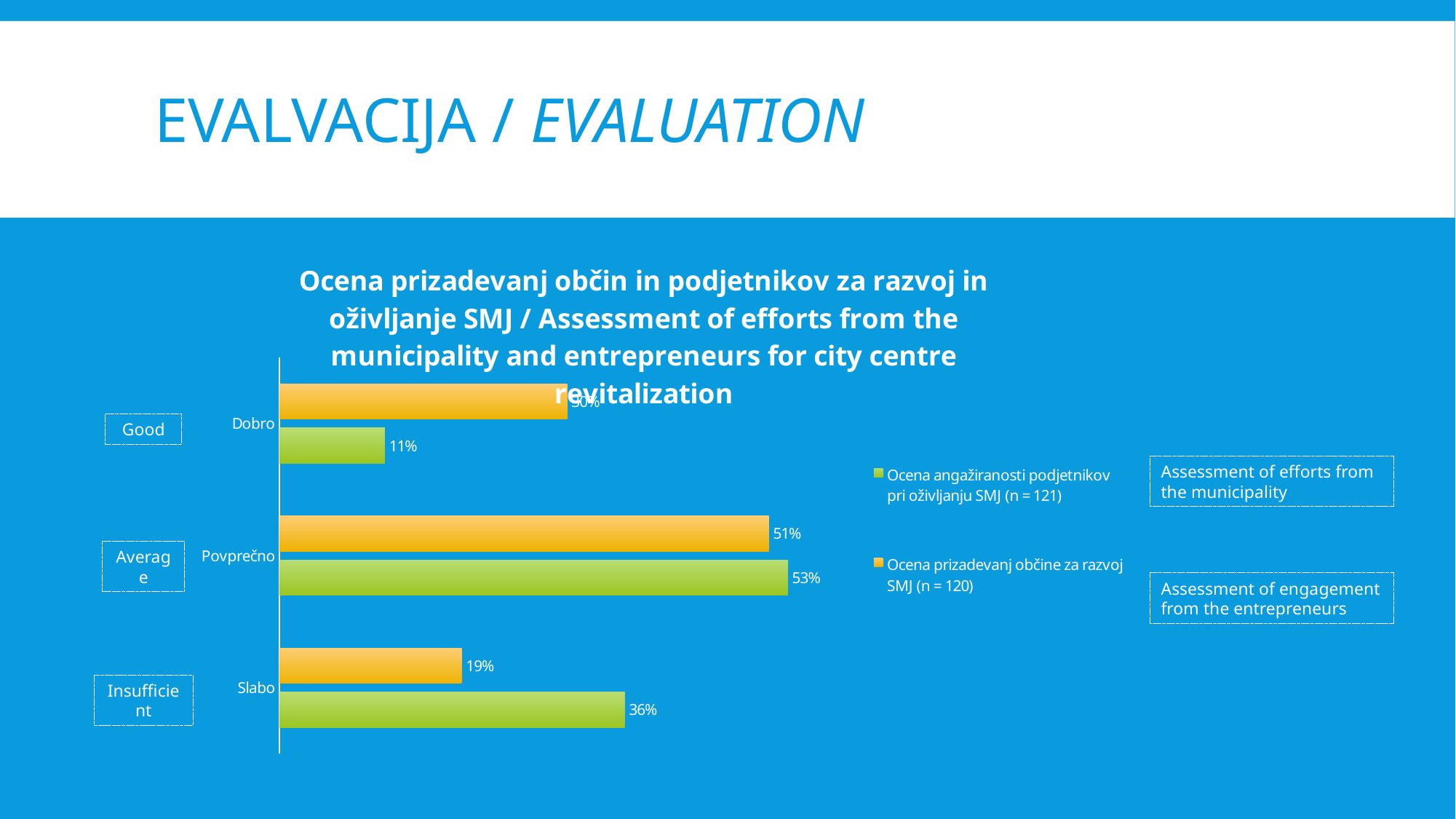
Which category has the highest value for the orange series (Ocena prizadevanj občine)? Povprečno What is the value of the orange series (Ocena prizadevanj občine) for the Slabo category? 19% Which category has the lowest value for the green series (Ocena angažiranosti podjetnikov)? Dobro For the Slabo category, which series has the larger value: the green (entrepreneurs) or the orange (municipality)? The green series (Ocena angažiranosti podjetnikov), 36% What is the value of the green series (Ocena angažiranosti podjetnikov) for the Povprečno category? 53% How many series does the legend list? 2 Which category has the highest value for the green series (Ocena angažiranosti podjetnikov)? Povprečno How many categories are shown on the chart? 3 What is the value of the green series (Ocena angažiranosti podjetnikov) for the Dobro category? 11% What is the value of the green series (Ocena angažiranosti podjetnikov) for the Slabo category? 36% What is the value of the orange series (Ocena prizadevanj občine) for the Povprečno category? 51% For the Slabo category, what is the difference between the green series value and the orange series value? 17 percentage points